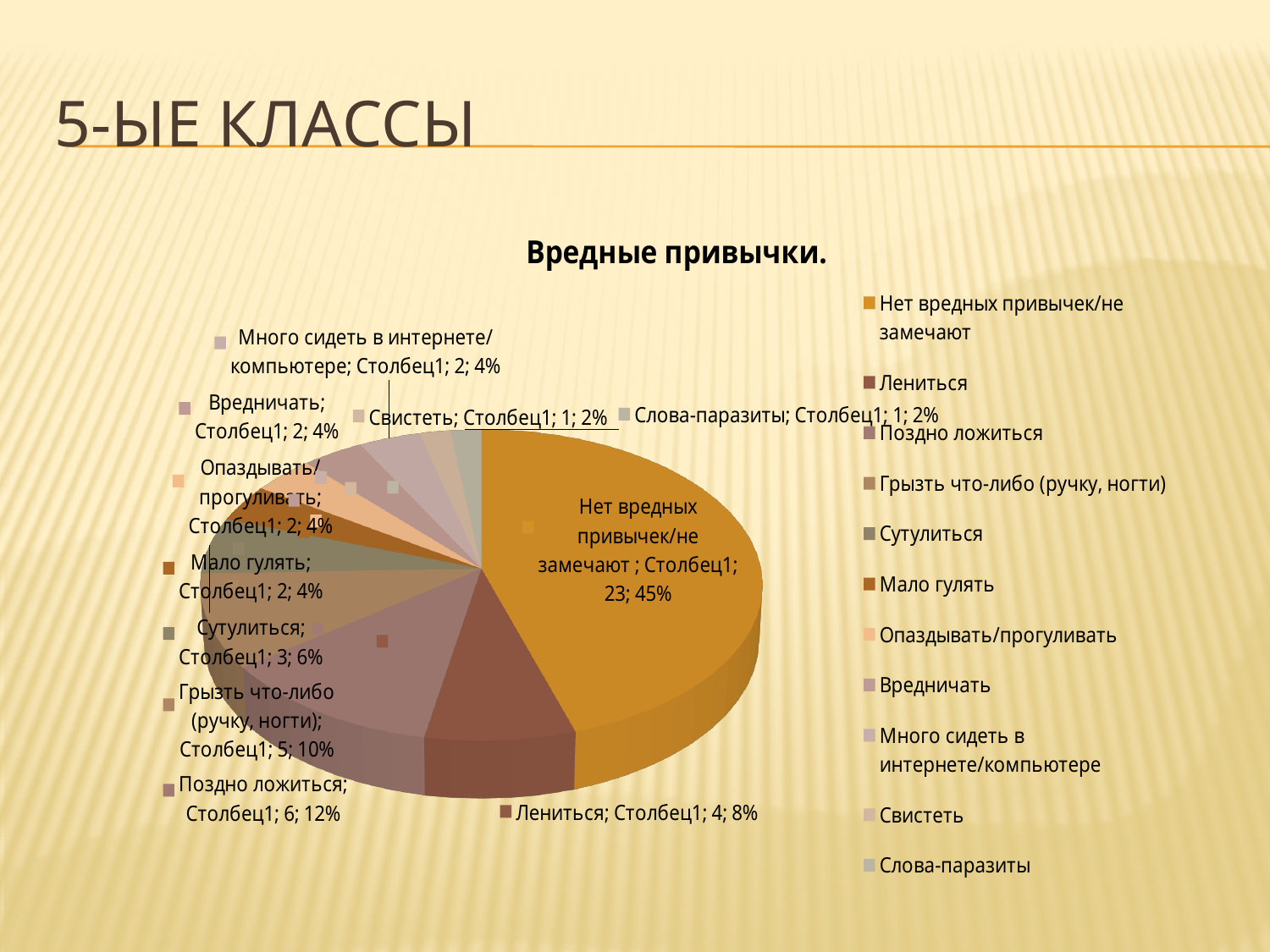
What value is shown for "Грызть что-либо (ручку, ногти)"? 5 What percentage share does the slice "Лениться" have? 8% What is the difference between the values for "Поздно ложиться" and "Сутулиться"? 3 What percentage share does the slice "Поздно ложиться" have? 12% What percentage share does the slice "Мало гулять" have? 4% What is the title of the chart? Вредные привычки. What value is shown for the slice "Свистеть"? 1 Which is larger, the value for "Лениться" or the value for "Грызть что-либо (ручку, ногти)"? Грызть что-либо (ручку, ногти) What kind of chart is shown on the slide? Pie chart What value is shown for the slice "Нет вредных привычек/не замечают"? 23 Which category has the largest slice of the pie? Нет вредных привычек/не замечают How many categories (slices) does the pie chart have? 11